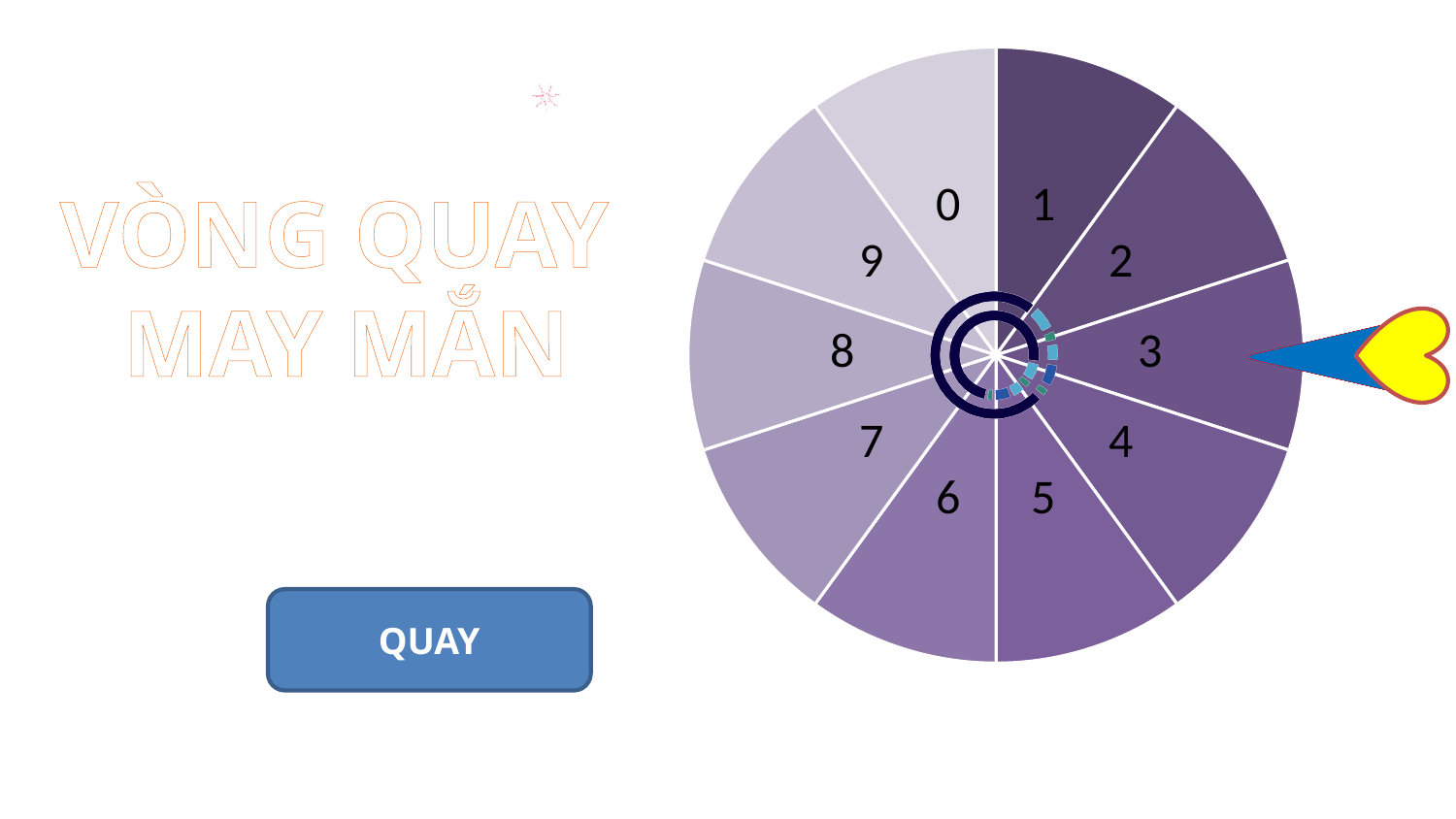
Which slice of the pie chart does the arrow on the right point to? 3 How many slices does the pie chart have? 10 What kind of chart is the wheel on the right of the slide? pie chart What is the title shown to the left of the pie chart? VÒNG QUAY MAY MẮN What labels appear on the slices of the pie chart? 0 to 9